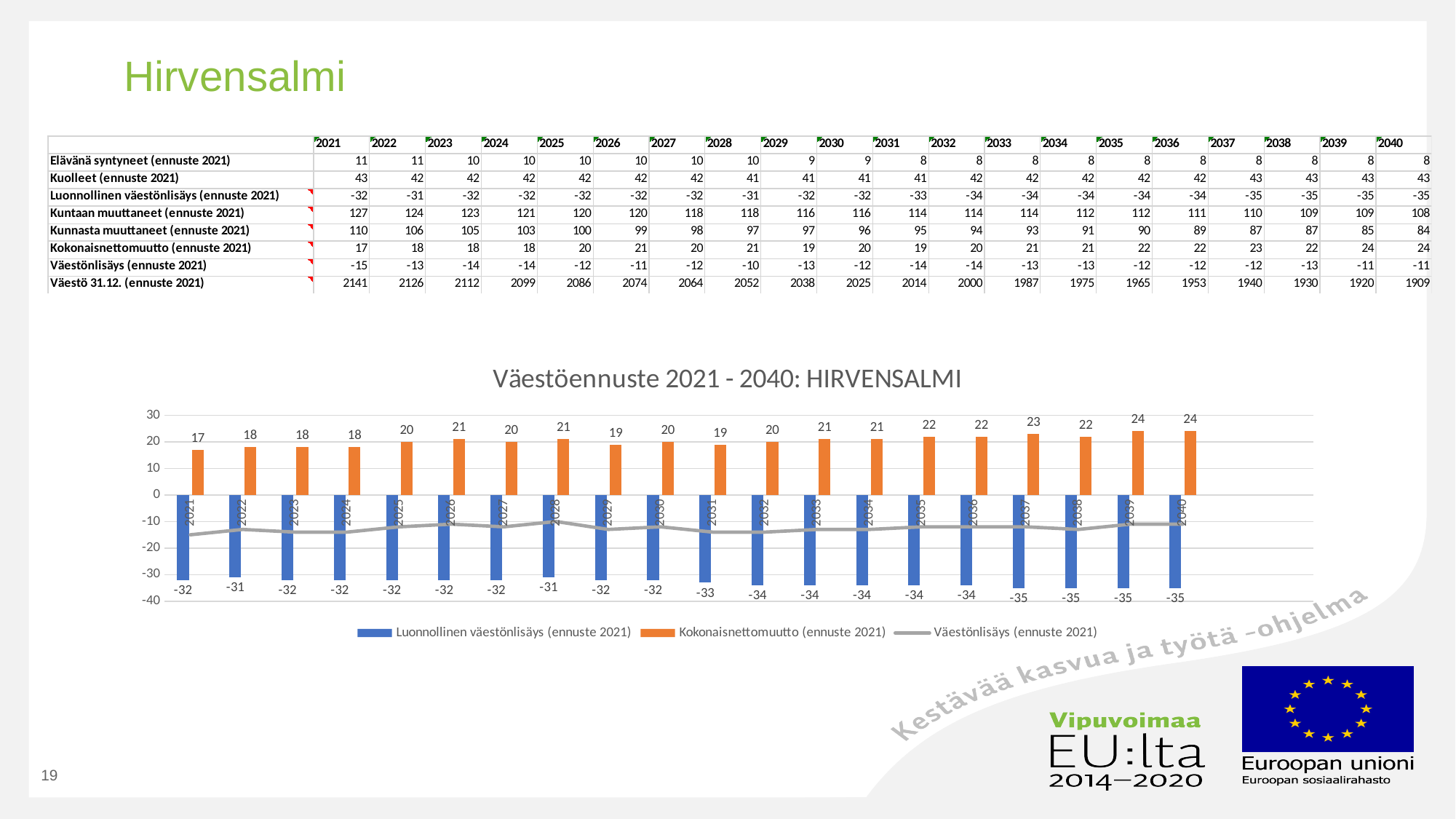
What is the lowest value of Luonnollinen väestönlisäys (ennuste 2021) shown in the chart? -35 In which year is Kokonaisnettomuutto (ennuste 2021) lowest in the chart? 2021 How many years are plotted on the x axis of the chart? 20 What is the value of Luonnollinen väestönlisäys (ennuste 2021) for 2040 in the chart? -35 What is the value of Luonnollinen väestönlisäys (ennuste 2021) for 2022 in the chart? -31 What is the difference between Kokonaisnettomuutto (ennuste 2021) in 2040 and in 2021? 7 What is the title of the chart? Väestöennuste 2021 - 2040: HIRVENSALMI How many series does the chart legend list? 3 What is the value of Kokonaisnettomuutto (ennuste 2021) for 2021 in the chart? 17 What kind of chart is shown on the slide? bar chart with a line Which year has the larger Kokonaisnettomuutto (ennuste 2021) value, 2026 or 2029? 2026 Does Kokonaisnettomuutto (ennuste 2021) generally rise or fall from 2021 to 2040? rise